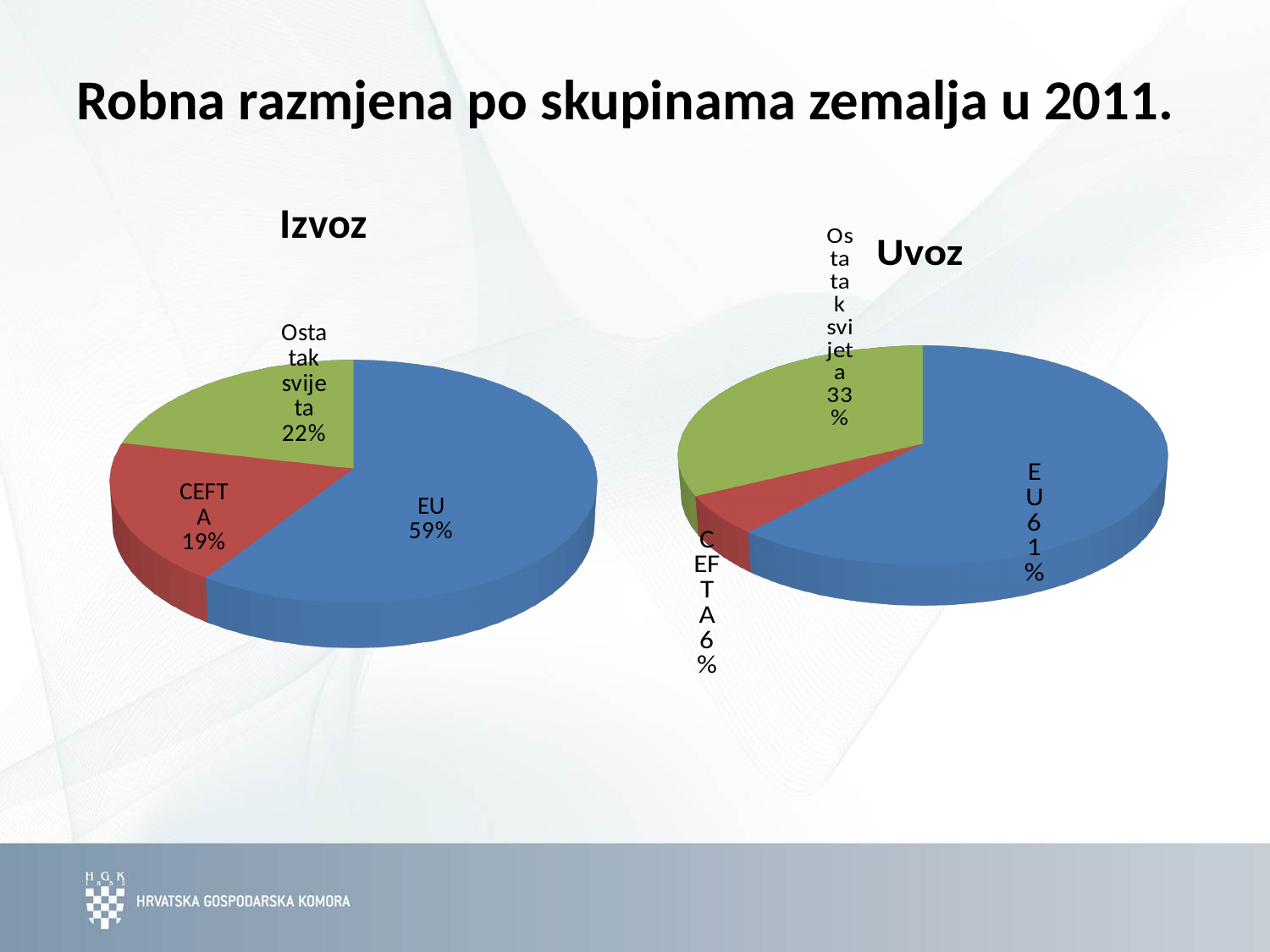
What type of chart is the Izvoz chart? Pie chart In the Izvoz chart, which category has the largest share? EU In the Izvoz chart, what is the difference between the EU share and the CEFTA share? 40% In the Uvoz chart, what share does EU have? 61% In the Izvoz chart, what share does EU have? 59% In the Uvoz chart, which category has the smallest share? CEFTA How many slices does the Uvoz chart have? 3 In the Izvoz chart, what share does Ostatak svijeta have? 22% Which is larger: the CEFTA share in the Izvoz chart or the CEFTA share in the Uvoz chart? Izvoz In the Uvoz chart, what share does Ostatak svijeta have? 33% In the Uvoz chart, what share does CEFTA have? 6% In the Izvoz chart, what share does CEFTA have? 19%